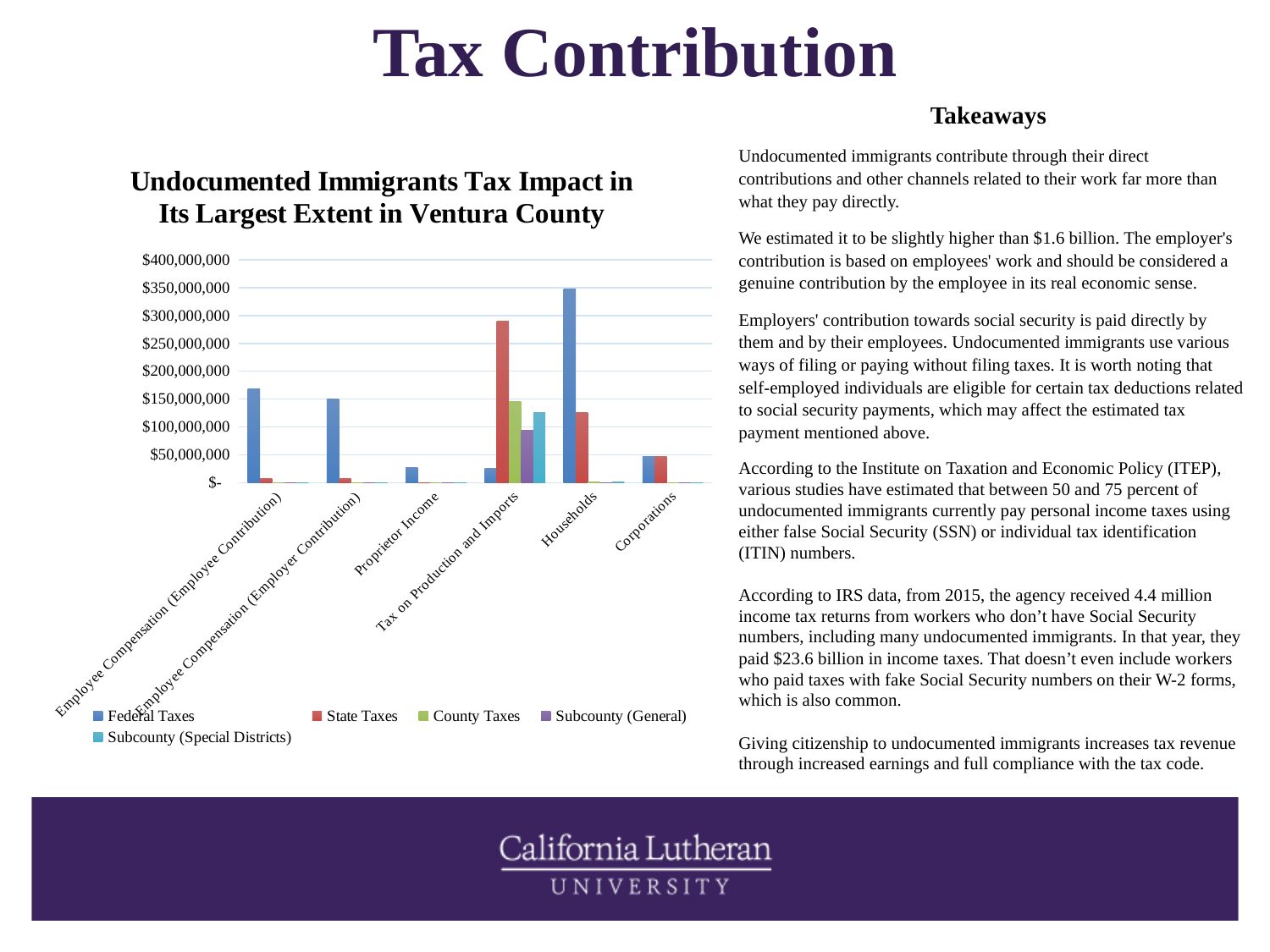
What is the title of the chart? Undocumented Immigrants Tax Impact in Its Largest Extent in Ventura County Is the Federal Taxes value for Employee Compensation (Employee Contribution) greater or less than $150,000,000? greater How many categories are shown along the x axis of the chart? 6 Which category has the highest Federal Taxes value? Households Which category has the highest State Taxes value? Tax on Production and Imports Is the State Taxes value for Tax on Production and Imports greater or less than $250,000,000? greater Which is larger for Tax on Production and Imports: the County Taxes value or the Subcounty (General) value? County Taxes Is the Federal Taxes value for Households greater or less than $300,000,000? greater Which is larger for Households: the Federal Taxes value or the State Taxes value? Federal Taxes How many series does the chart's legend list? 5 What kind of chart is shown on the slide? Bar chart